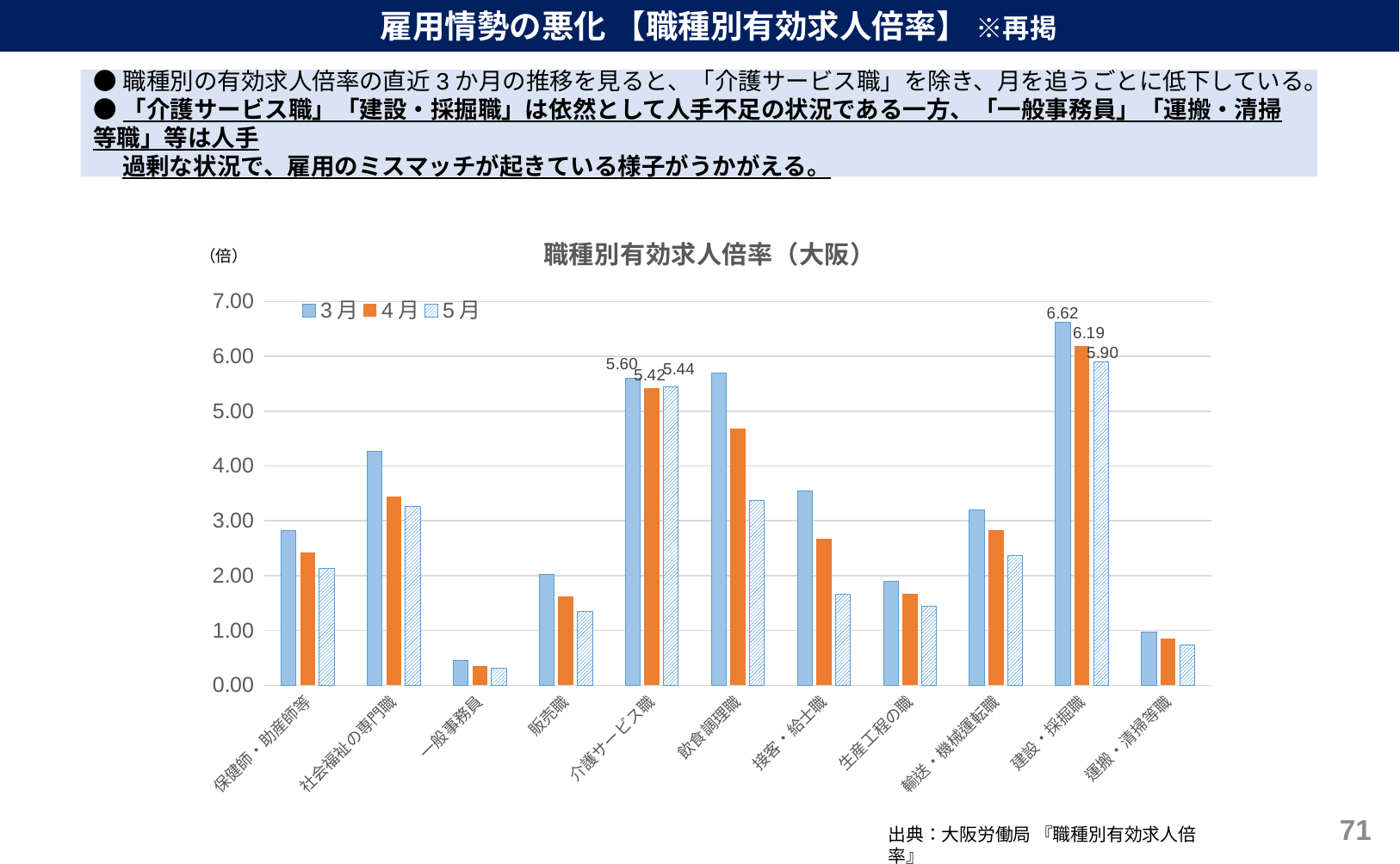
What is the value for 介護サービス職 in 4月? 5.42 What is the difference between the 3月 and 5月 values for 建設・採掘職? 0.72 How many series does the legend of the chart list? 3 What is the title of the chart? 職種別有効求人倍率（大阪） Which is larger for 社会福祉の専門職: the 3月 value or the 5月 value? 3月 How many occupation categories are shown on the x axis of the chart? 11 What is the value for 建設・採掘職 in 3月? 6.62 Which occupation has the highest value in 3月? 建設・採掘職 What is the value for 建設・採掘職 in 5月? 5.90 Is the 3月 value for 飲食調理職 greater or less than 5.00? greater What kind of chart is shown on the slide? bar chart Which occupation has the lowest value in 5月? 一般事務員